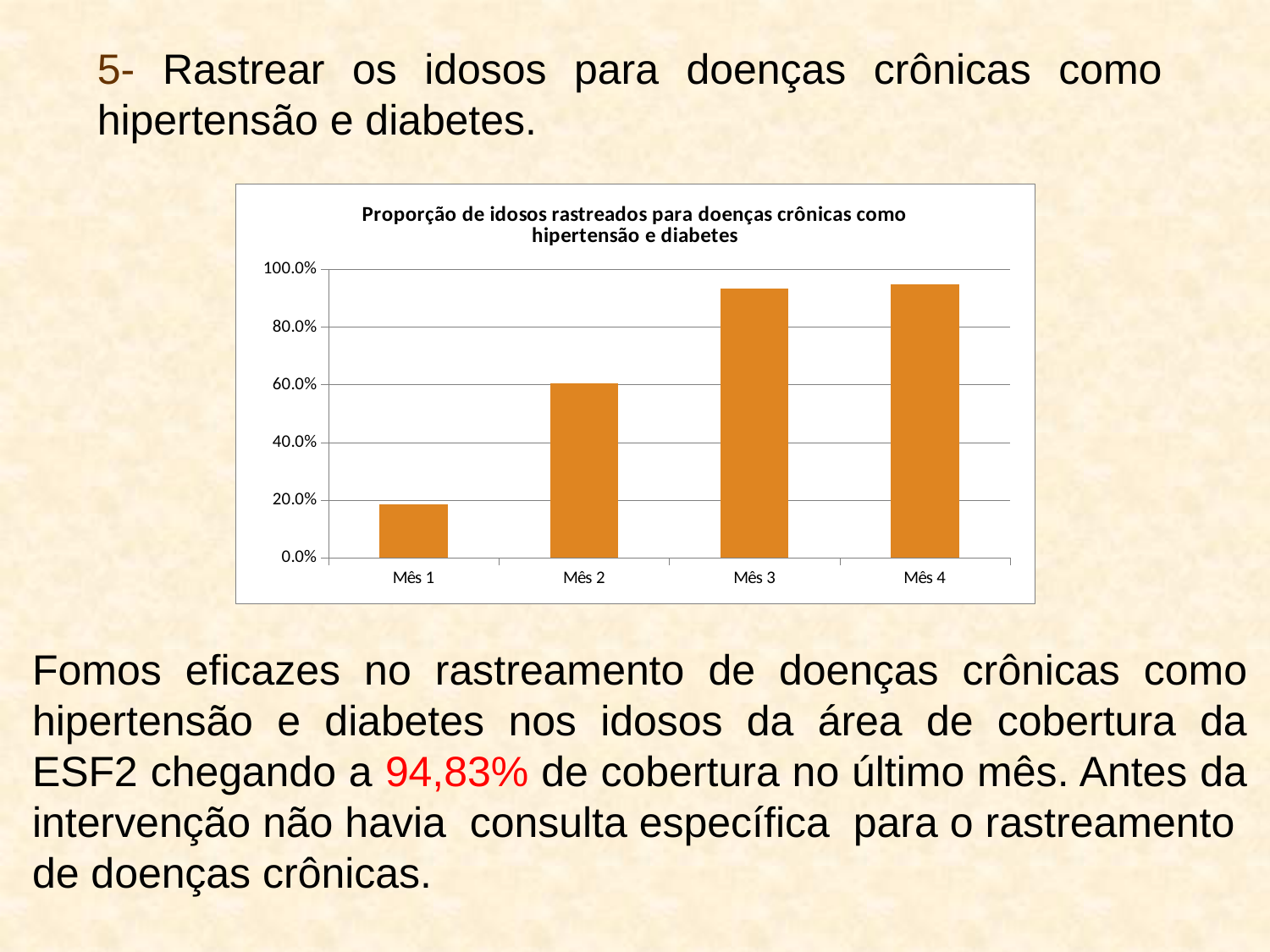
Is the value for Mês 3 greater or less than 80.0%? greater Is the value for Mês 2 greater or less than 80.0%? less Is the value for Mês 1 greater or less than 20.0%? less Which is larger, the value for Mês 1 or the value for Mês 2? Mês 2 Which month has the lowest proportion in the chart? Mês 1 What kind of chart is shown on the slide? bar chart Do the values rise or fall from Mês 1 to Mês 4? rise Which is larger, the value for Mês 2 or the value for Mês 3? Mês 3 What is the title of the chart? Proporção de idosos rastreados para doenças crônicas como hipertensão e diabetes How many months (categories) are shown on the x axis of the chart? 4